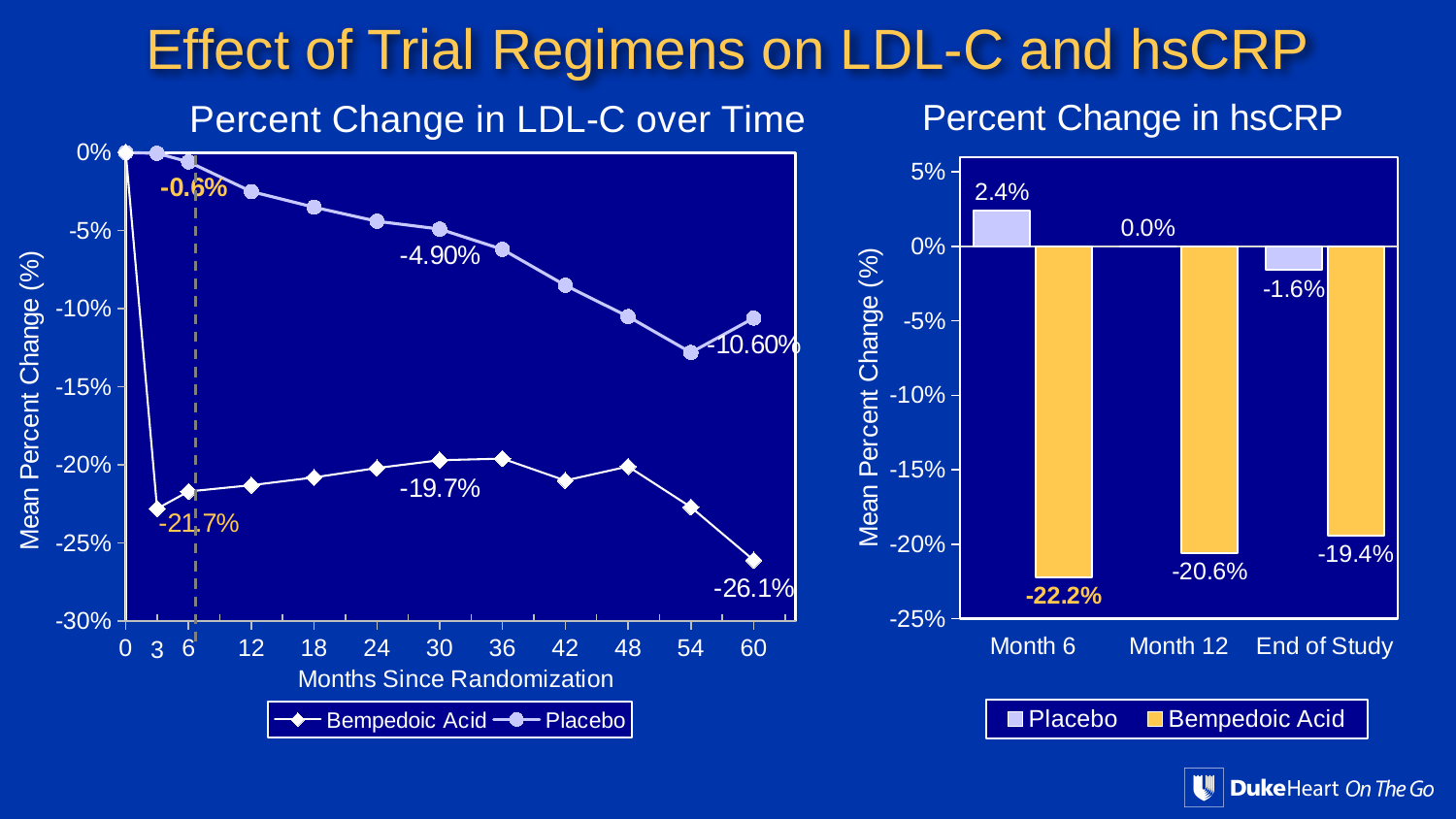
In the Percent Change in LDL-C over Time chart, what is the Placebo value at month 60? -10.60% In the Percent Change in LDL-C over Time chart, what is the difference between the Placebo and Bempedoic Acid values at month 60? 15.5 percentage points In the Percent Change in hsCRP chart, what is the value for Placebo at End of Study? -1.6% In the Percent Change in LDL-C over Time chart, what is the Bempedoic Acid value at month 6? -21.7% What kind of chart is the Percent Change in LDL-C over Time chart? Line chart In the Percent Change in LDL-C over Time chart, does the Placebo line generally rise or fall from month 0 to month 54? Fall In the Percent Change in hsCRP chart, how many categories are shown on the x axis? 3 In the Percent Change in hsCRP chart, what is the value for Placebo at Month 12? 0.0% In the Percent Change in hsCRP chart, what is the value for Bempedoic Acid at Month 6? -22.2% In the Percent Change in hsCRP chart, which category has the lowest Bempedoic Acid value? Month 6 In the Percent Change in hsCRP chart, what is the difference between the Placebo and Bempedoic Acid values at Month 12? 20.6 percentage points In the Percent Change in hsCRP chart, how many series does the legend list? 2